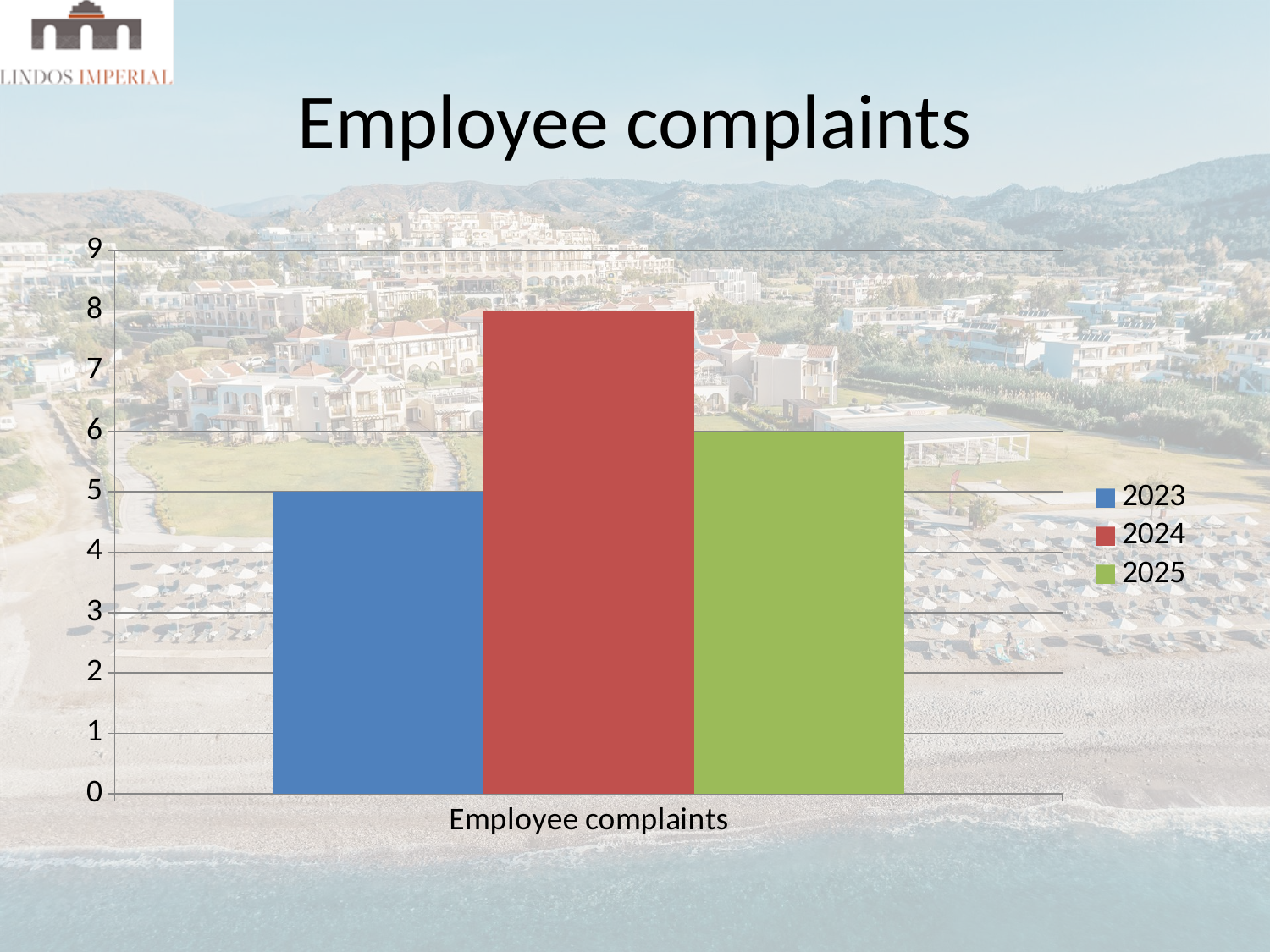
Which year has the lowest number of employee complaints? 2023 What is the value for 2025 in the Employee complaints chart? 6 What kind of chart is shown on the slide? bar chart What is the value for 2024 in the Employee complaints chart? 8 How many series does the legend list? 3 What is the difference between the values for 2024 and 2025? 2 What is the value for 2023 in the Employee complaints chart? 5 Which is larger, the value for 2025 or the value for 2023? 2025 What is the difference between the values for 2024 and 2023? 3 Is the value for 2024 greater or less than 7? greater Which year has the highest number of employee complaints? 2024 What is the title of the chart on the slide? Employee complaints